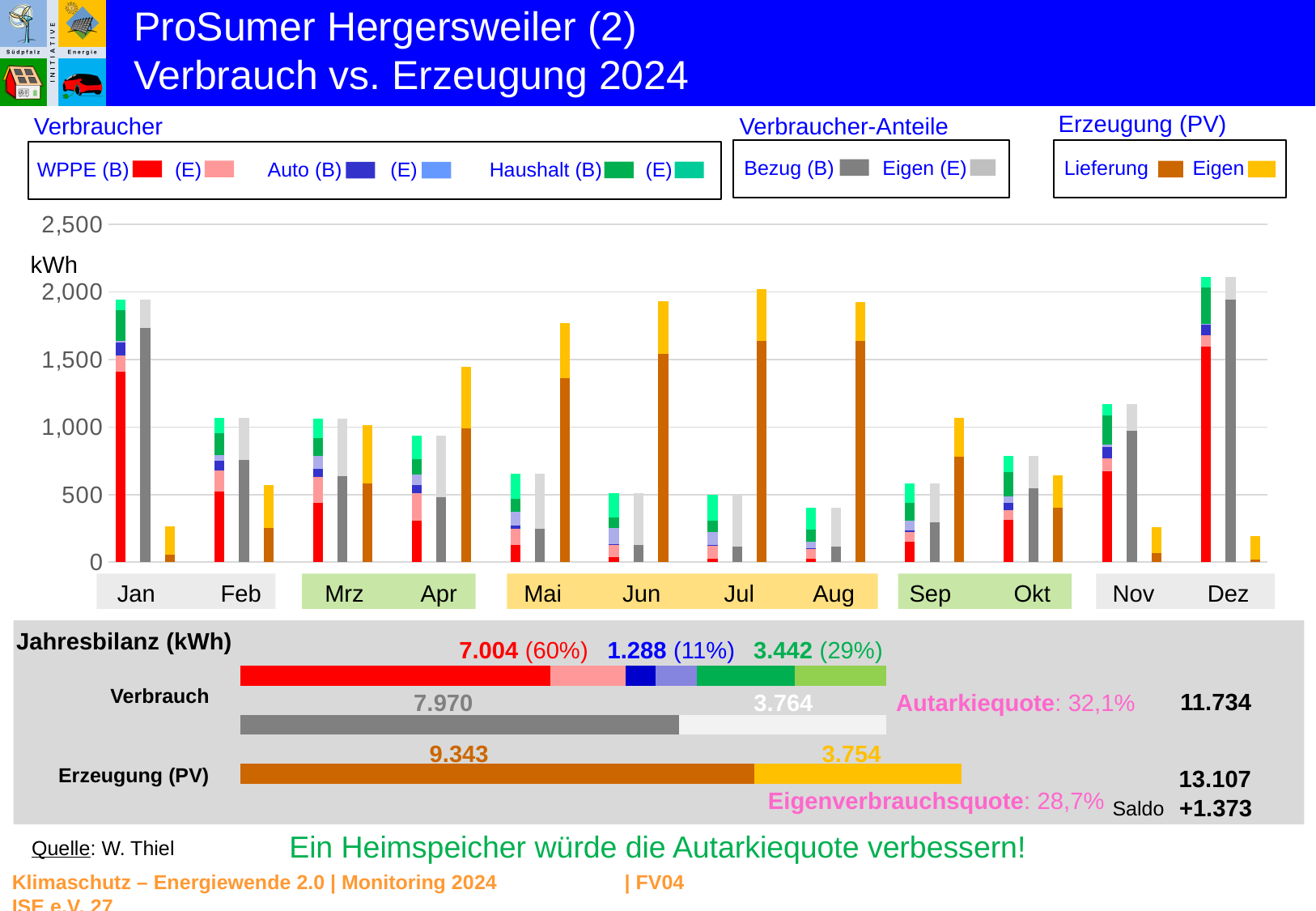
In the monthly chart, is the PV generation (Erzeugung) bar for Mai greater or less than 1,500 kWh? greater In the monthly chart, which month has the lowest total consumption (Verbraucher bar)? Aug How many entries does the Verbraucher legend list? 6 In the monthly chart, is the PV generation (Erzeugung) bar for Jan greater or less than 500 kWh? less In the Jahresbilanz, what is the Autarkiequote? 32,1% In the monthly chart, is the total consumption bar for Dez greater or less than 2,000 kWh? greater What kind of chart is the monthly chart showing Verbrauch vs. Erzeugung 2024? Stacked bar chart How many entries does the Erzeugung (PV) legend list? 2 How many months are shown on the x axis of the monthly chart? 12 In the Jahresbilanz, what is the total annual Erzeugung (PV) in kWh? 13.107 In the Jahresbilanz, what is the annual WPPE consumption in kWh? 7.004 In the monthly chart, which month has the highest total consumption (Verbraucher bar)? Dez